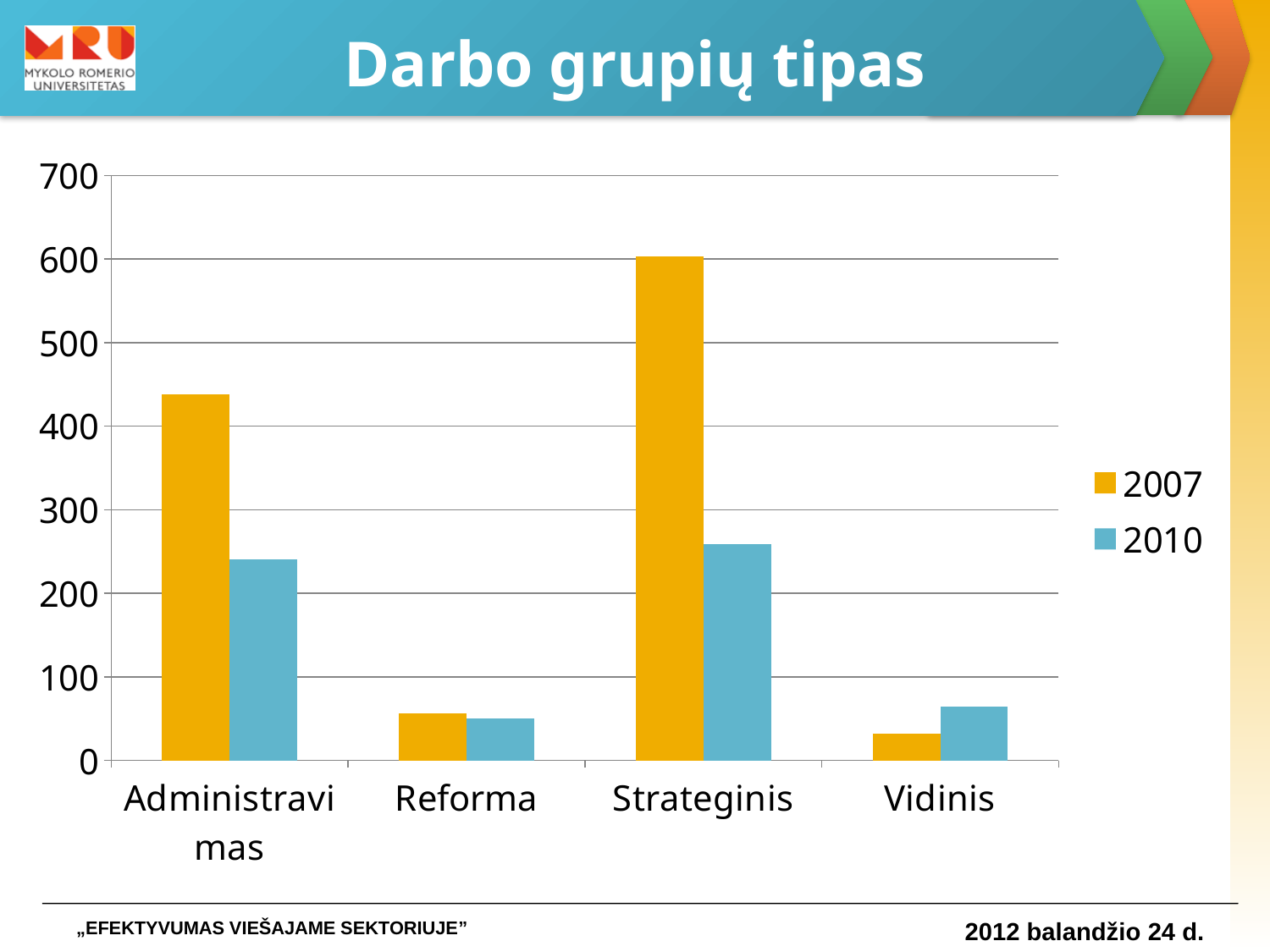
Which category has the highest value for 2007? Strateginis What kind of chart is shown on the slide? bar chart For Administravimas, which is larger: the 2007 value or the 2010 value? 2007 Which category has the highest value for 2010? Strateginis Is the 2007 value for Strateginis greater or less than 500? greater How many categories are shown on the x axis? 4 Which category has the lowest value for 2007? Vidinis Is the 2010 value for Administravimas greater or less than 300? less Which series are listed in the legend? 2007 and 2010 What is the title of the chart? Darbo grupių tipas For Vidinis, which is larger: the 2007 value or the 2010 value? 2010 How many series does the legend list? 2